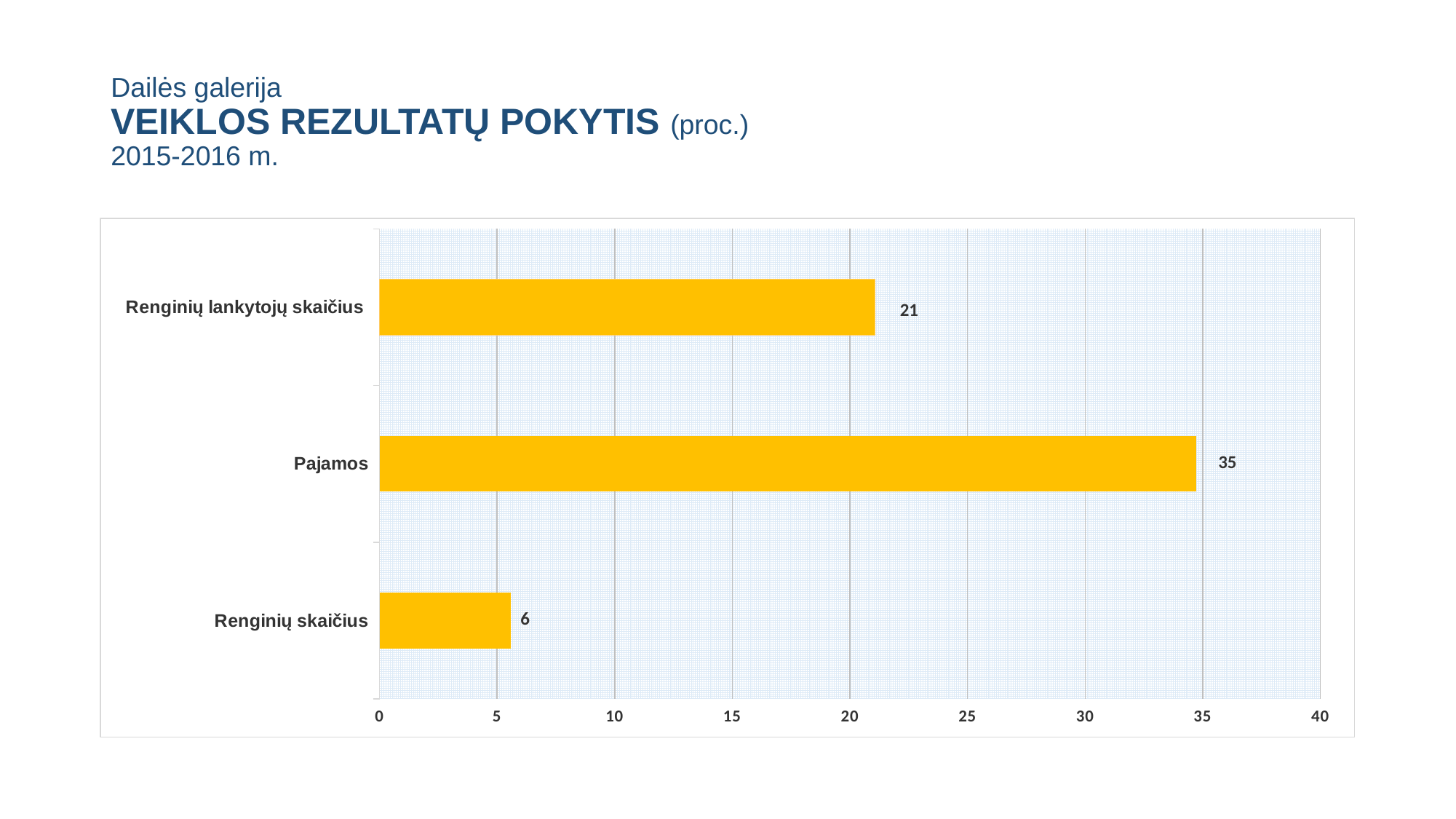
What is the value for Pajamos? 35 Which category has the highest value? Pajamos What is the value for Renginių lankytojų skaičius? 21 What is the value for Renginių skaičius? 6 What is the maximum value shown on the horizontal axis? 40 Which category has the lowest value? Renginių skaičius What is the difference between the values for Pajamos and Renginių lankytojų skaičius? 14 How many categories are shown in the chart? 3 What is the difference between the values for Renginių lankytojų skaičius and Renginių skaičius? 15 Which is larger, the value for Renginių lankytojų skaičius or the value for Renginių skaičius? Renginių lankytojų skaičius Is the value for Pajamos greater or less than 30? greater What kind of chart is shown on the slide? Bar chart